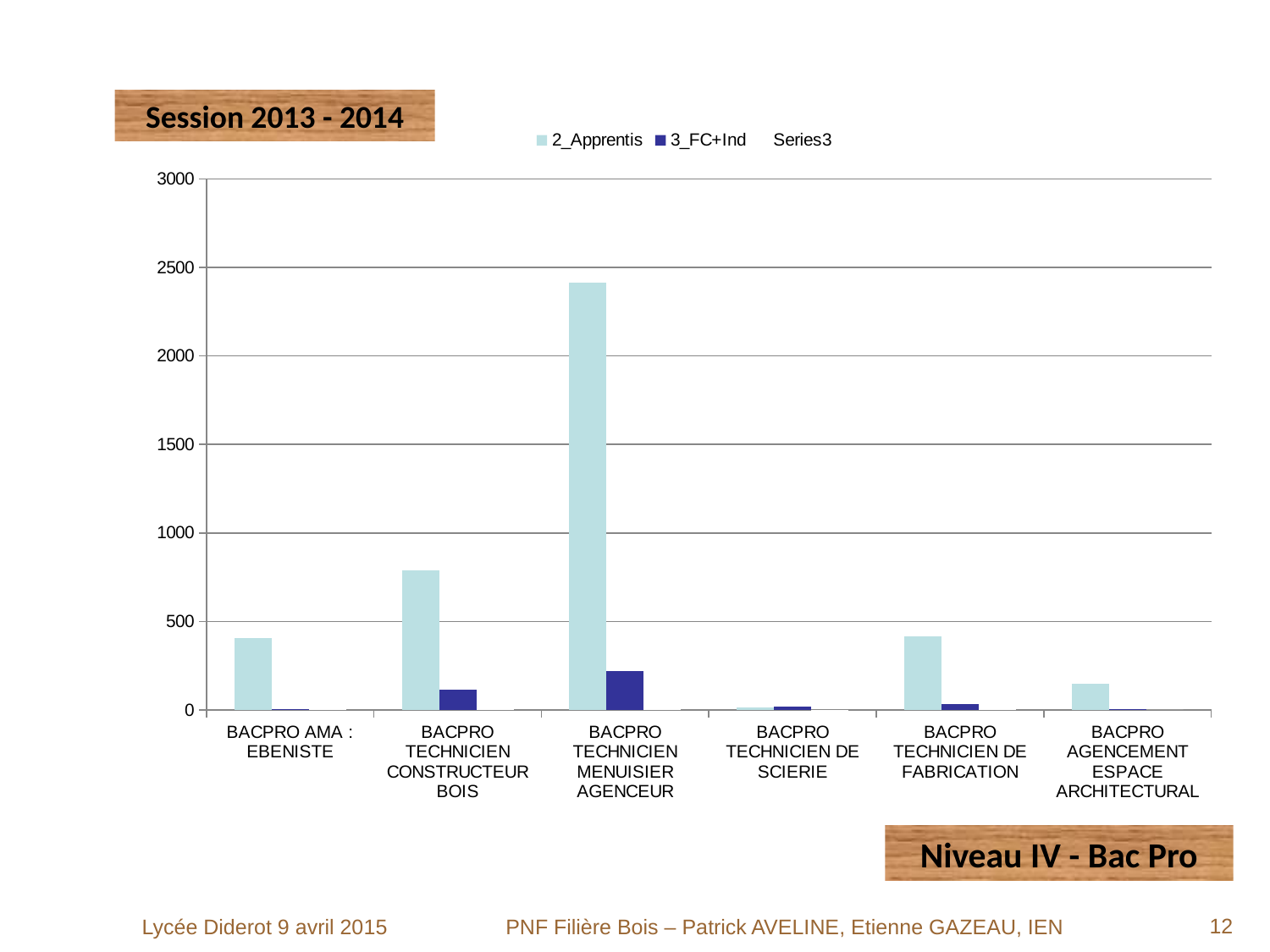
How many categories are shown along the x axis of the chart? 6 What kind of chart is shown on the slide? bar chart Which category has the highest 2_Apprentis value? BACPRO TECHNICIEN MENUISIER AGENCEUR Is the 2_Apprentis value for BACPRO TECHNICIEN CONSTRUCTEUR BOIS greater or less than 500? greater Which category has the lowest 2_Apprentis value? BACPRO TECHNICIEN DE SCIERIE Is the 2_Apprentis value for BACPRO AMA : EBENISTE greater or less than 500? less Is the 2_Apprentis value for BACPRO TECHNICIEN CONSTRUCTEUR BOIS greater or less than 1000? less What is the session label shown in the top-left box of the slide? Session 2013 - 2014 Which is larger, the 2_Apprentis value for BACPRO TECHNICIEN CONSTRUCTEUR BOIS or for BACPRO AMA : EBENISTE? BACPRO TECHNICIEN CONSTRUCTEUR BOIS Which category has the highest 3_FC+Ind value? BACPRO TECHNICIEN MENUISIER AGENCEUR How many series does the chart legend list? 3